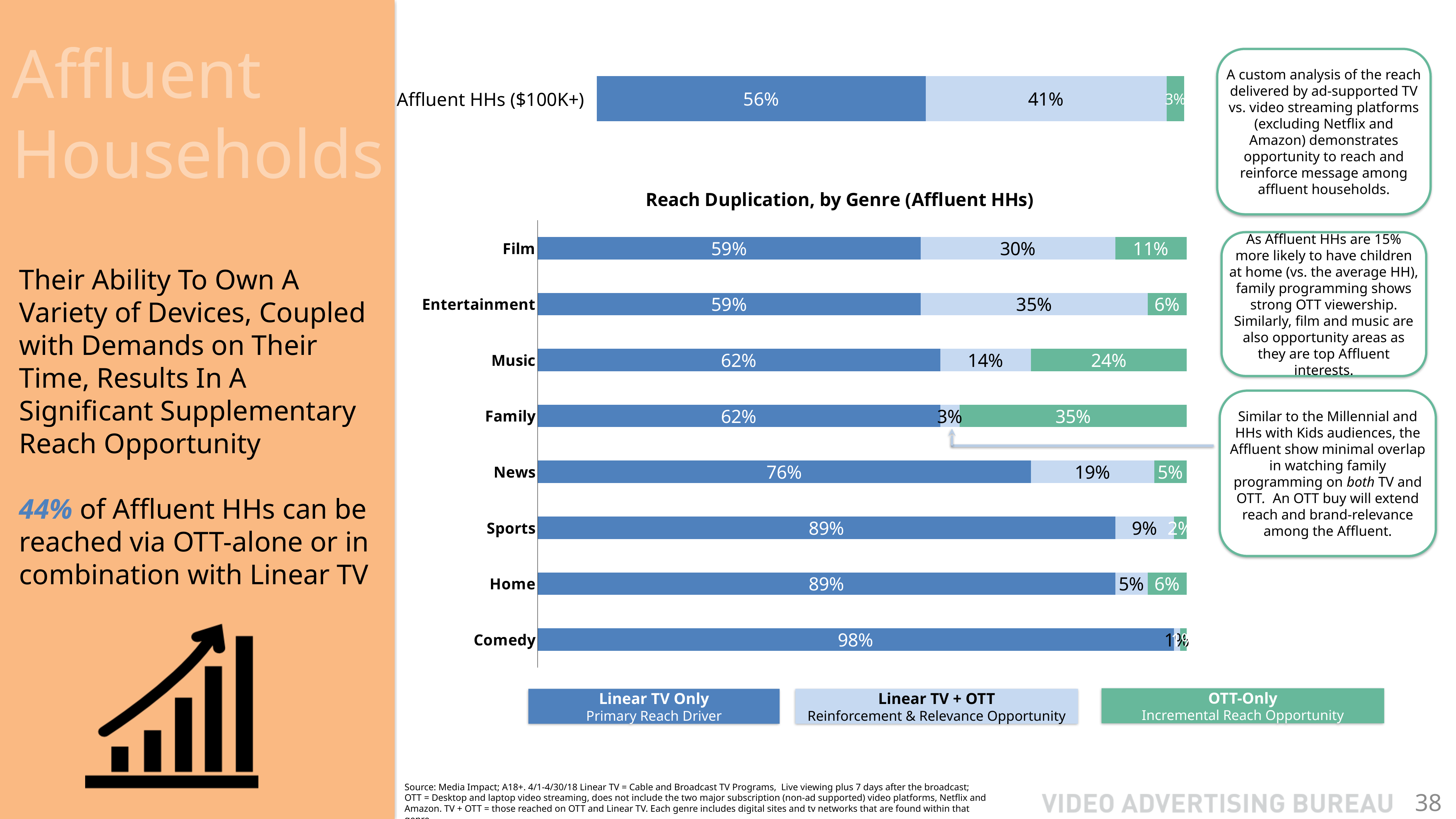
In the 'Reach Duplication, by Genre (Affluent HHs)' chart, which genre has the highest OTT-Only value? Family In the 'Reach Duplication, by Genre (Affluent HHs)' chart, what is the difference between the Linear TV + OTT values for Film and Music? 16% What type of chart is the 'Reach Duplication, by Genre (Affluent HHs)' chart? Stacked horizontal bar chart How many series does the legend of the 'Reach Duplication, by Genre (Affluent HHs)' chart list? 3 In the 'Reach Duplication, by Genre (Affluent HHs)' chart, which genre has the lowest Linear TV Only value? Film and Entertainment (59%) How many genres are shown in the 'Reach Duplication, by Genre (Affluent HHs)' chart? 8 In the 'Reach Duplication, by Genre (Affluent HHs)' chart, what is the Linear TV + OTT value for Entertainment? 35% In the top chart for Affluent HHs ($100K+), what is the Linear TV + OTT value? 41% In the 'Reach Duplication, by Genre (Affluent HHs)' chart, what is the OTT-Only value for Music? 24% In the 'Reach Duplication, by Genre (Affluent HHs)' chart, is the OTT-Only value larger for Film or for Home? Film In the 'Reach Duplication, by Genre (Affluent HHs)' chart, which genre has the highest Linear TV Only value? Comedy In the 'Reach Duplication, by Genre (Affluent HHs)' chart, what is the Linear TV Only value for News? 76%